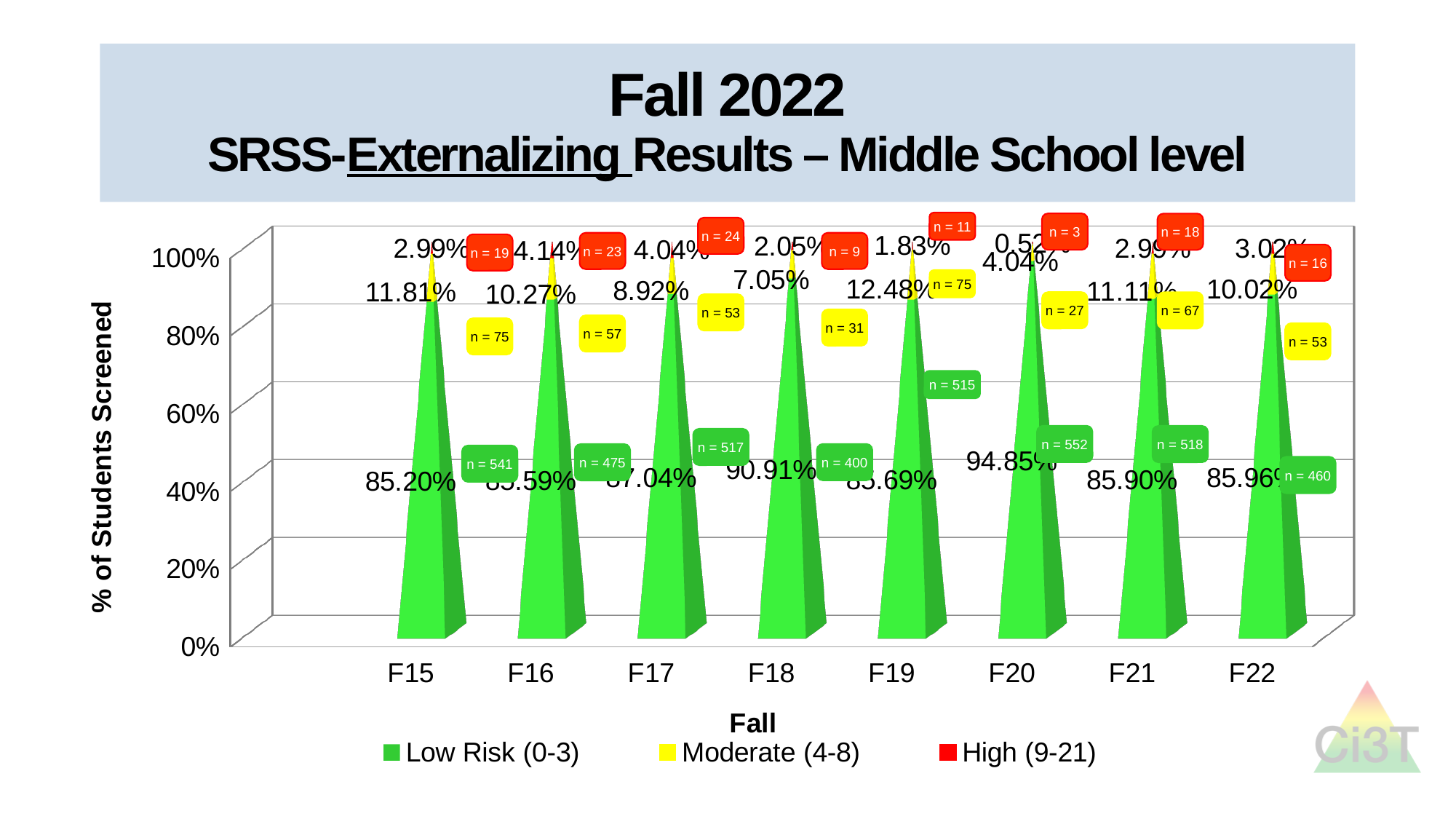
What percentage of students screened were Low Risk (0-3) in F15? 85.20% What kind of chart is shown on the slide? Stacked bar chart What is the label of the y axis? % of Students Screened In which Fall did the High (9-21) group have the lowest percentage? F20 In which Fall did the Low Risk (0-3) group have the highest percentage? F20 Which is larger, the High (9-21) percentage in F16 or in F18? F16 What percentage of students screened were Moderate (4-8) in F18? 7.05% How many Fall categories are shown on the x axis? 8 How many series does the legend list? 3 What percentage of students screened were High (9-21) in F17? 4.04% What is the n value shown for the Low Risk (0-3) group in F20? n = 552 What is the difference between the Moderate (4-8) and High (9-21) percentages in F15? 8.82%